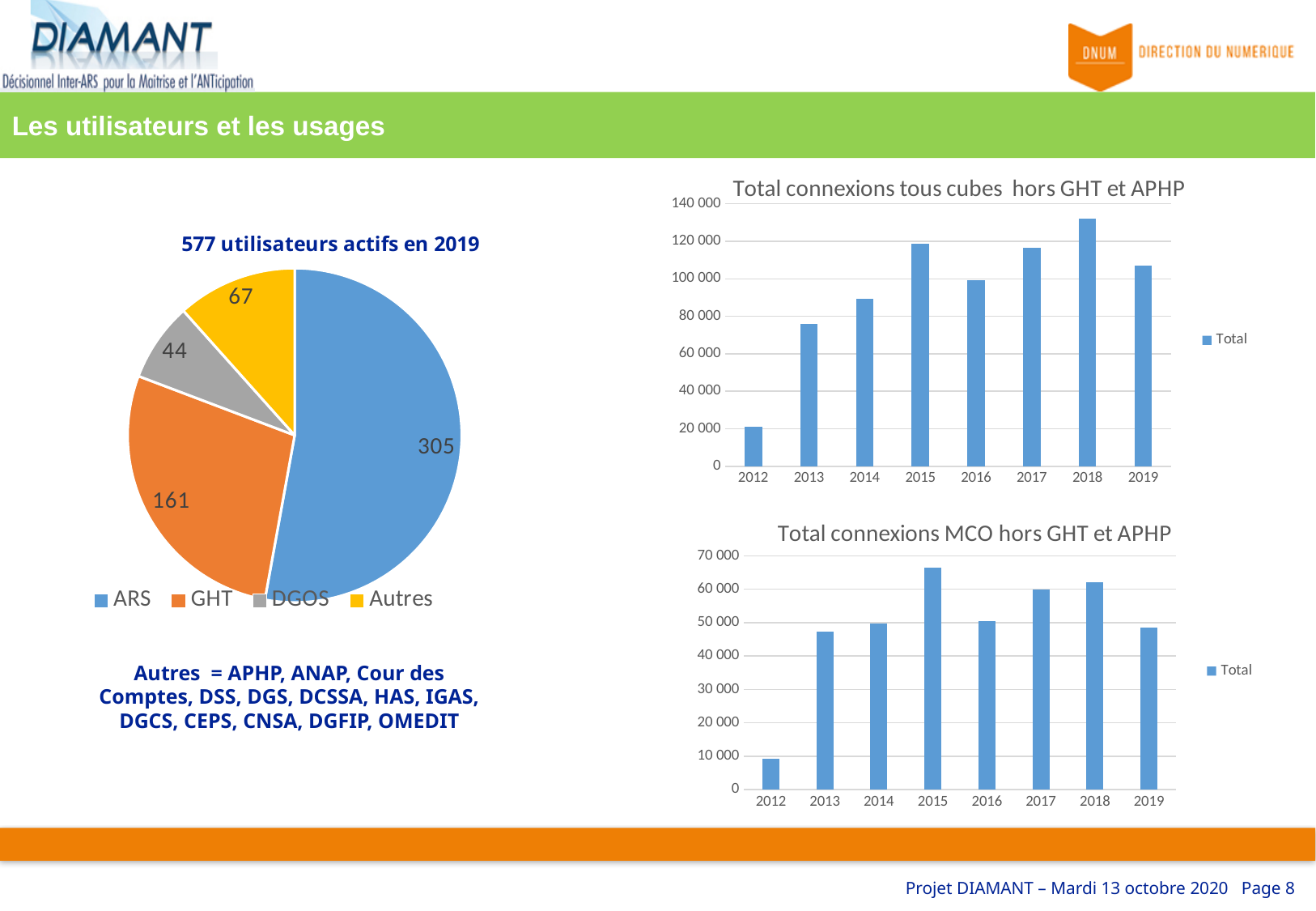
In the pie chart '577 utilisateurs actifs en 2019', what is the value for GHT? 161 In the pie chart '577 utilisateurs actifs en 2019', which is larger, Autres or DGOS? Autres In the pie chart '577 utilisateurs actifs en 2019', which category has the smallest slice? DGOS What kind of chart is 'Total connexions MCO hors GHT et APHP'? bar chart In the pie chart '577 utilisateurs actifs en 2019', what is the value for ARS? 305 In the chart 'Total connexions tous cubes hors GHT et APHP', which year has the highest value? 2018 In the chart 'Total connexions MCO hors GHT et APHP', which year has the highest value? 2015 In the chart 'Total connexions tous cubes hors GHT et APHP', which year has the lowest value? 2012 In the chart 'Total connexions MCO hors GHT et APHP', is the value for 2013 greater or less than 50 000? less How many categories does the pie chart '577 utilisateurs actifs en 2019' show? 4 In the chart 'Total connexions tous cubes hors GHT et APHP', is the value for 2018 greater or less than 120 000? greater In the pie chart '577 utilisateurs actifs en 2019', what is the difference between the ARS and GHT values? 144